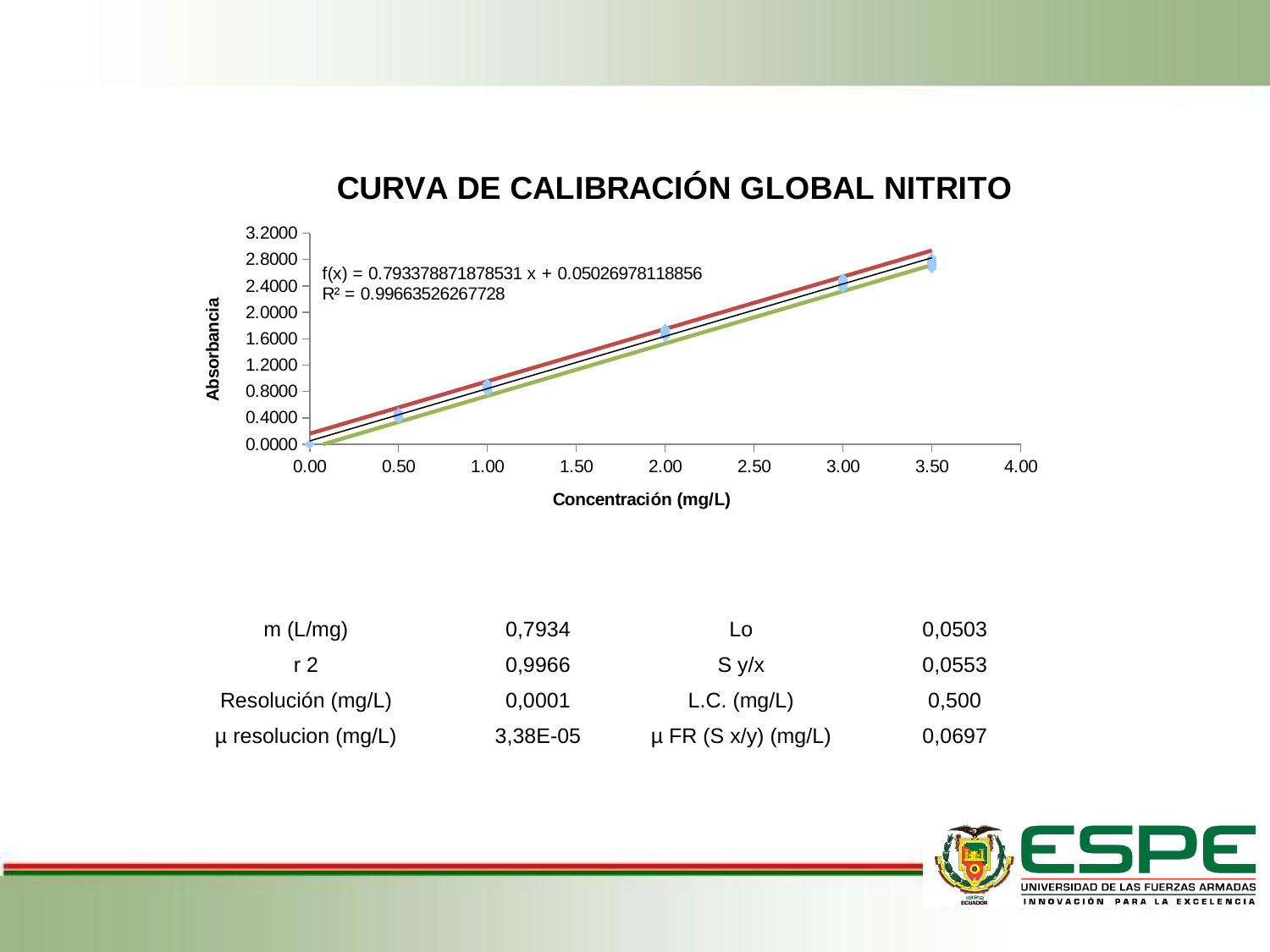
Is the absorbance at a concentration of 2.00 mg/L greater or less than 1.2000? greater What kind of chart is shown on the slide? scatter chart At which concentration is the absorbance highest? 3.50 What is the title of the chart? CURVA DE CALIBRACIÓN GLOBAL NITRITO At which concentration is the absorbance lowest? 0.00 What is the label of the y axis of the chart? Absorbancia Is the absorbance at a concentration of 0.50 mg/L greater or less than 0.8000? less Which has the larger absorbance, the point at 1.00 mg/L or the point at 3.00 mg/L? 3.00 mg/L Is the absorbance at a concentration of 3.50 mg/L greater or less than 2.4000? greater Do the absorbance values rise or fall as concentration increases along the x axis? rise